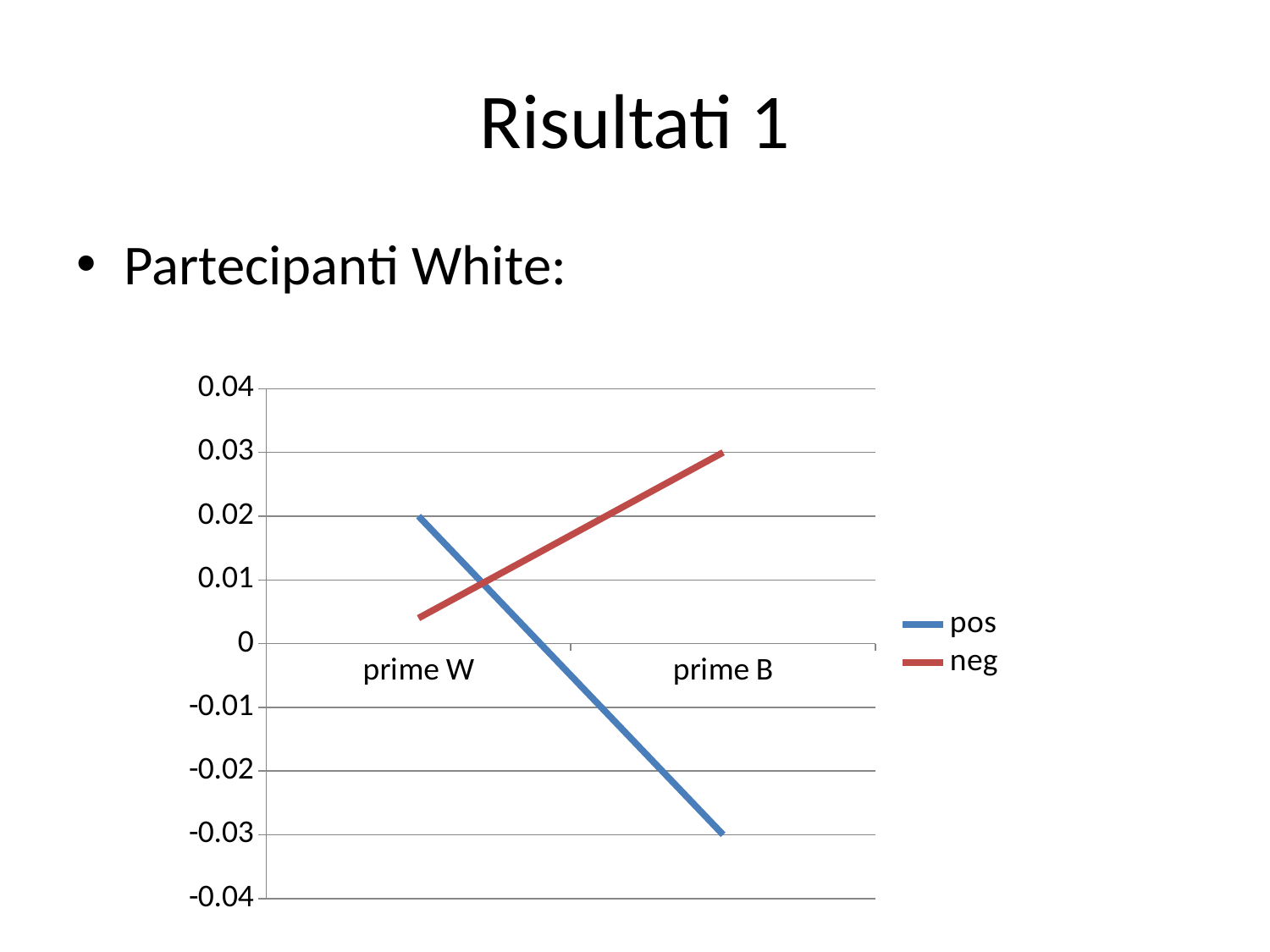
Is the value of the neg series at prime W greater or less than 0? greater At prime B, which series has the larger value, pos or neg? neg What is the value of the neg series at prime B? 0.03 How many series does the legend list? 2 How many categories are shown on the x axis? 2 Is the value of the neg series at prime W greater or less than 0.01? less What kind of chart is shown on the slide? line chart Does the pos series rise or fall from prime W to prime B? fall What is the value of the pos series at prime W? 0.02 What is the difference between the pos values at prime W and prime B? 0.05 What is the value of the pos series at prime B? -0.03 Does the neg series rise or fall from prime W to prime B? rise